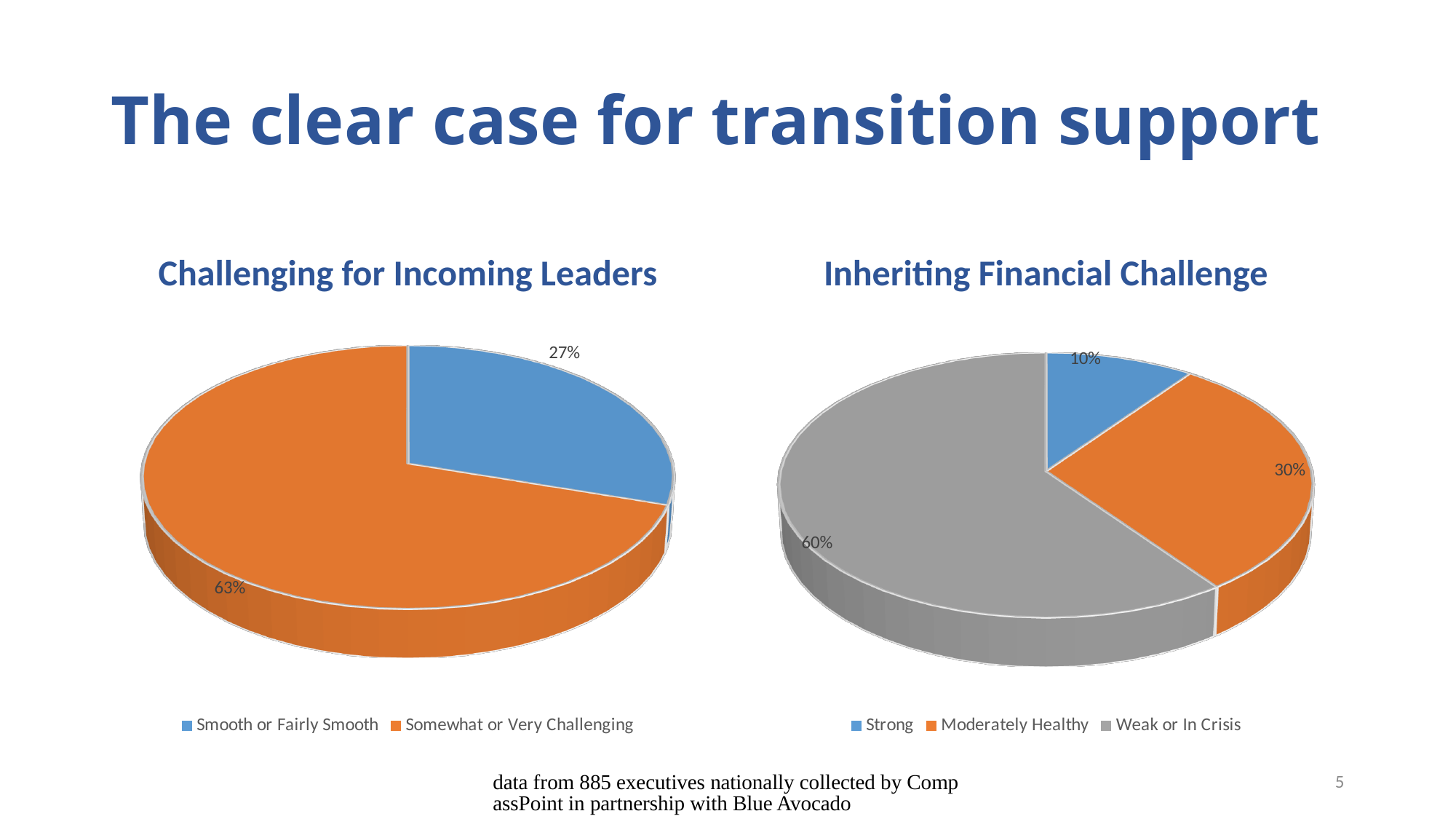
In the 'Inheriting Financial Challenge' chart, what share is labelled for 'Weak or In Crisis'? 60% In the 'Inheriting Financial Challenge' chart, what share is labelled for 'Moderately Healthy'? 30% In the 'Challenging for Incoming Leaders' chart, which category has the larger slice? Somewhat or Very Challenging In the 'Inheriting Financial Challenge' chart, what share is labelled for 'Strong'? 10% In the 'Challenging for Incoming Leaders' chart, what is the difference between the 'Somewhat or Very Challenging' and 'Smooth or Fairly Smooth' shares? 36% In the 'Inheriting Financial Challenge' chart, which category has the largest slice? Weak or In Crisis In the 'Inheriting Financial Challenge' chart, which category has the smallest slice? Strong How many categories does the legend of the 'Inheriting Financial Challenge' chart list? 3 In the 'Challenging for Incoming Leaders' chart, what share is labelled for 'Smooth or Fairly Smooth'? 27% In the 'Inheriting Financial Challenge' chart, what is the difference between the 'Weak or In Crisis' and 'Moderately Healthy' shares? 30% What type of chart is the 'Challenging for Incoming Leaders' chart? Pie chart In the 'Challenging for Incoming Leaders' chart, what share is labelled for 'Somewhat or Very Challenging'? 63%